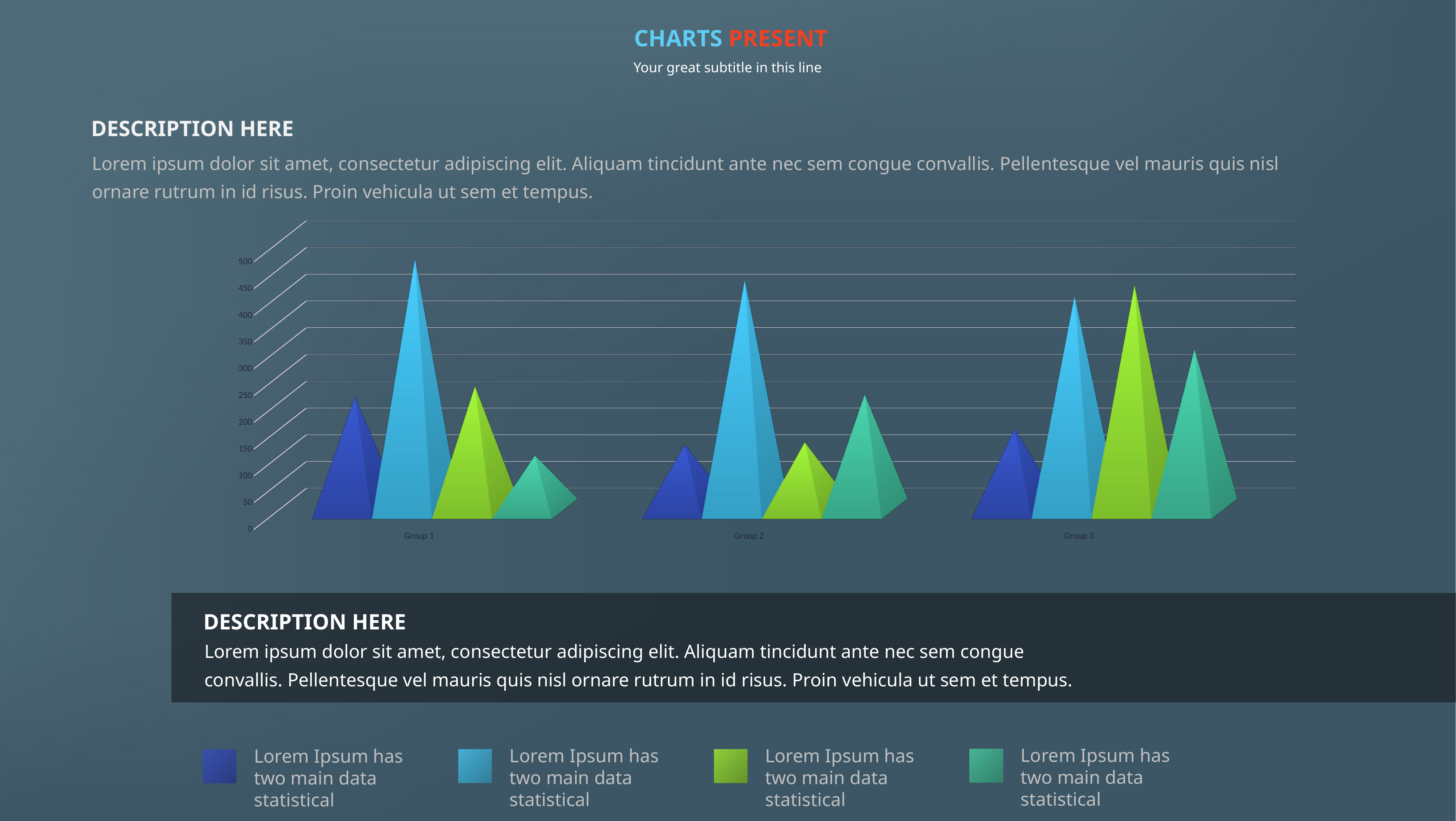
In Group 1, which coloured series has the tallest bar? light blue Is the light blue value for Group 1 greater or less than 400? greater Which group has the tallest teal bar? Group 3 Which group has the tallest light blue bar? Group 1 How many differently coloured series are plotted for each group in the chart? 4 Is the dark blue value for Group 2 greater or less than 250? less In Group 1, which coloured series has the shortest bar? teal Which is larger, the dark blue value for Group 1 or the dark blue value for Group 2? Group 1 How many groups (categories) are shown on the x axis of the chart? 3 Is the teal value for Group 1 greater or less than 200? less What kind of chart is shown on the slide? bar chart